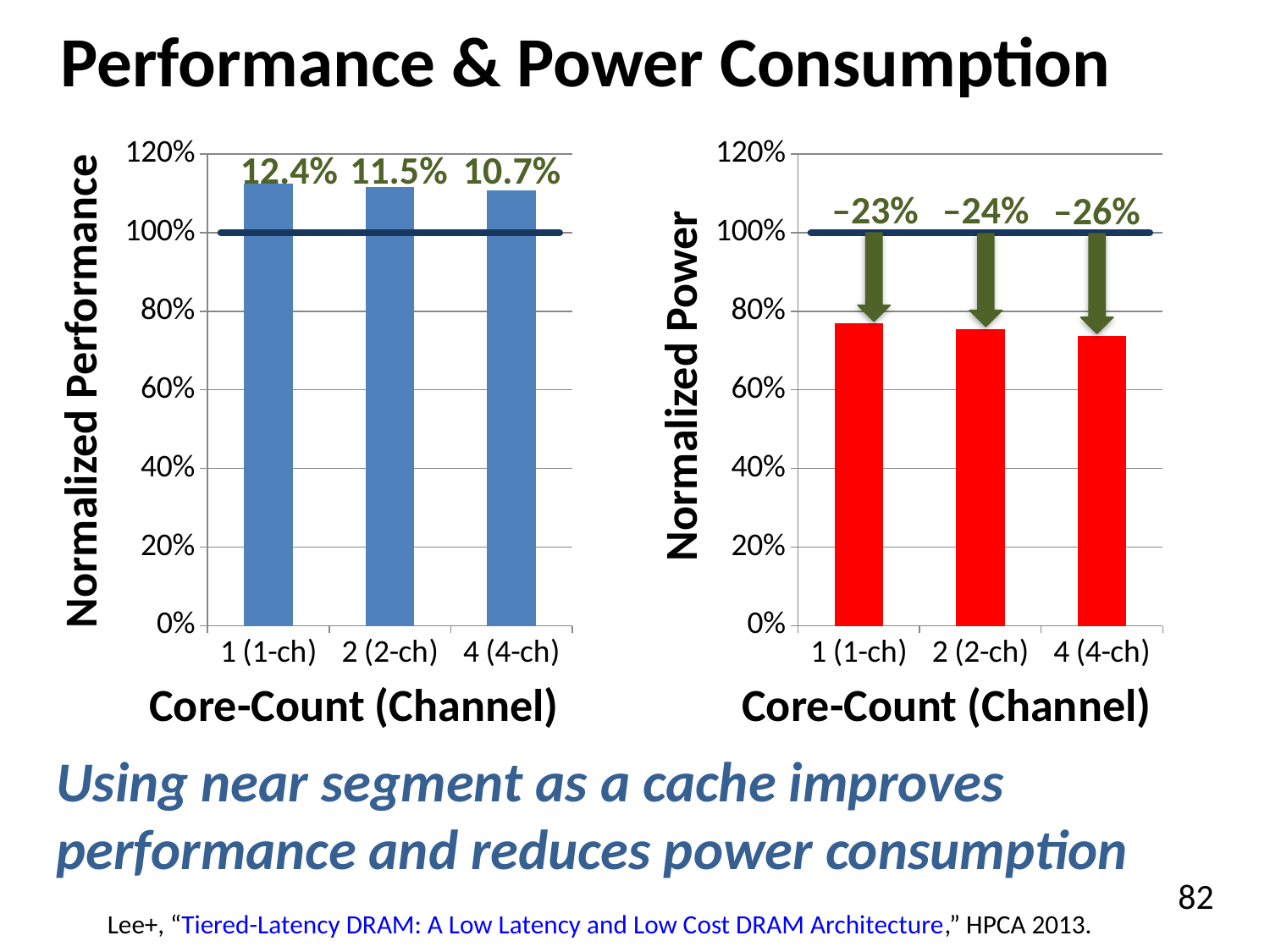
How many core-count configurations are shown on the Normalized Power chart (right)? 3 What kind of chart is the Normalized Performance chart (left)? bar chart On the Normalized Performance chart (left), what percentage label is shown above the 1 (1-ch) bar? 12.4% On the Normalized Power chart (right), is the bar for 1 (1-ch) greater or less than 80%? less On the Normalized Power chart (right), what percentage label is shown above the 2 (2-ch) bar? –24% On the Normalized Performance chart (left), what is the difference between the percentage labels for 1 (1-ch) and 4 (4-ch)? 1.7% On the Normalized Performance chart (left), which core-count configuration has the highest bar? 1 (1-ch) On the Normalized Performance chart (left), what percentage label is shown above the 4 (4-ch) bar? 10.7% On the Normalized Power chart (right), do the bar heights rise or fall as the core count increases from 1 to 4? fall On the Normalized Power chart (right), which core-count configuration has the lowest bar? 4 (4-ch) On the Normalized Performance chart (left), is the bar for 2 (2-ch) greater or less than 100%? greater On the Normalized Power chart (right), what percentage label is shown above the 4 (4-ch) bar? –26%